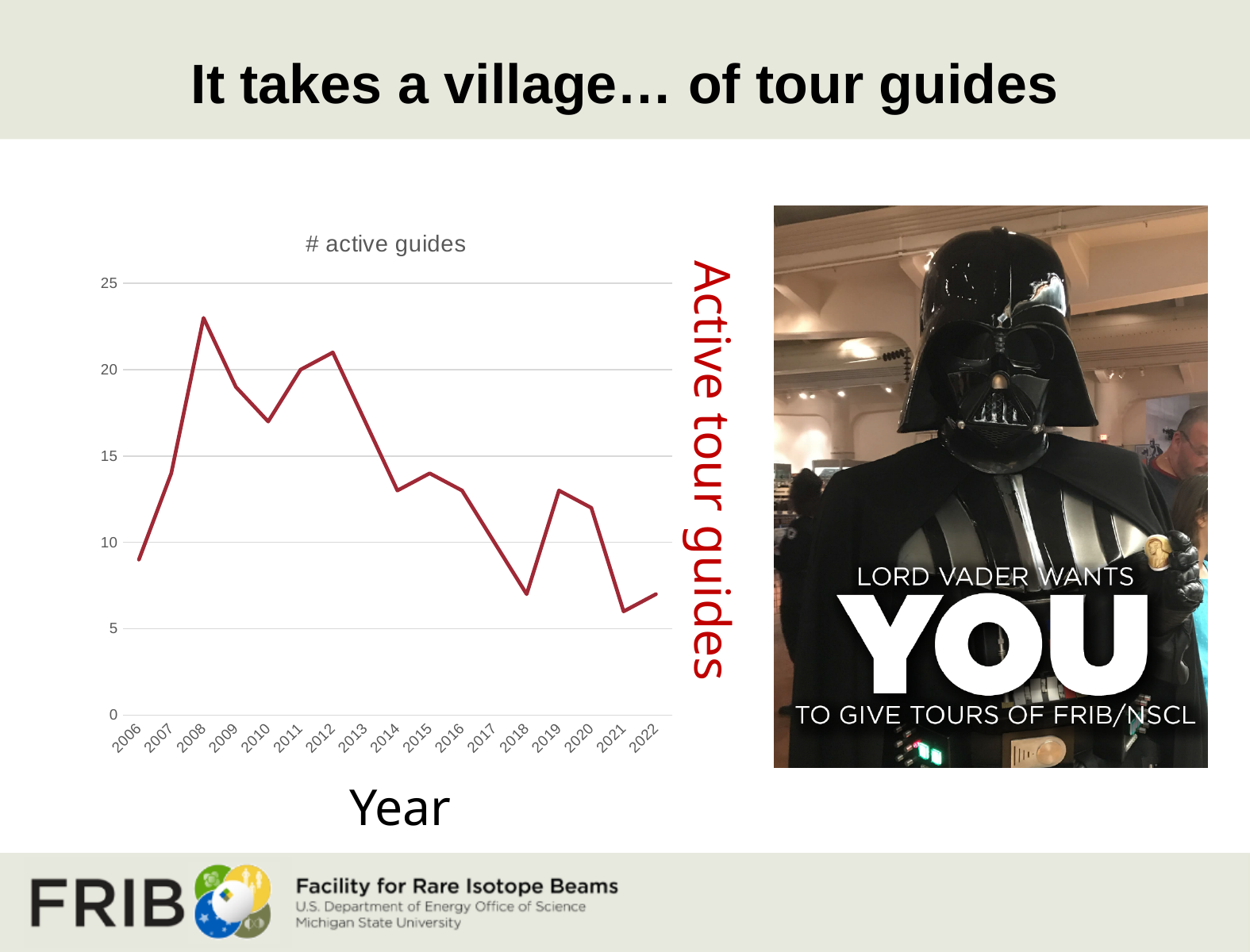
What is the label on the x axis of the chart? Year Is the value for 2006 greater or less than 10? less Which year has more active guides, 2008 or 2022? 2008 What kind of chart is shown on the slide? line chart Is the value for 2021 greater or less than 10? less Which year has the highest number of active guides? 2008 Overall, does the number of active guides rise or fall from 2008 to 2022? fall What is the title of the chart? # active guides Is the value for 2008 greater or less than 20? greater How many years are plotted on the x axis of the chart? 17